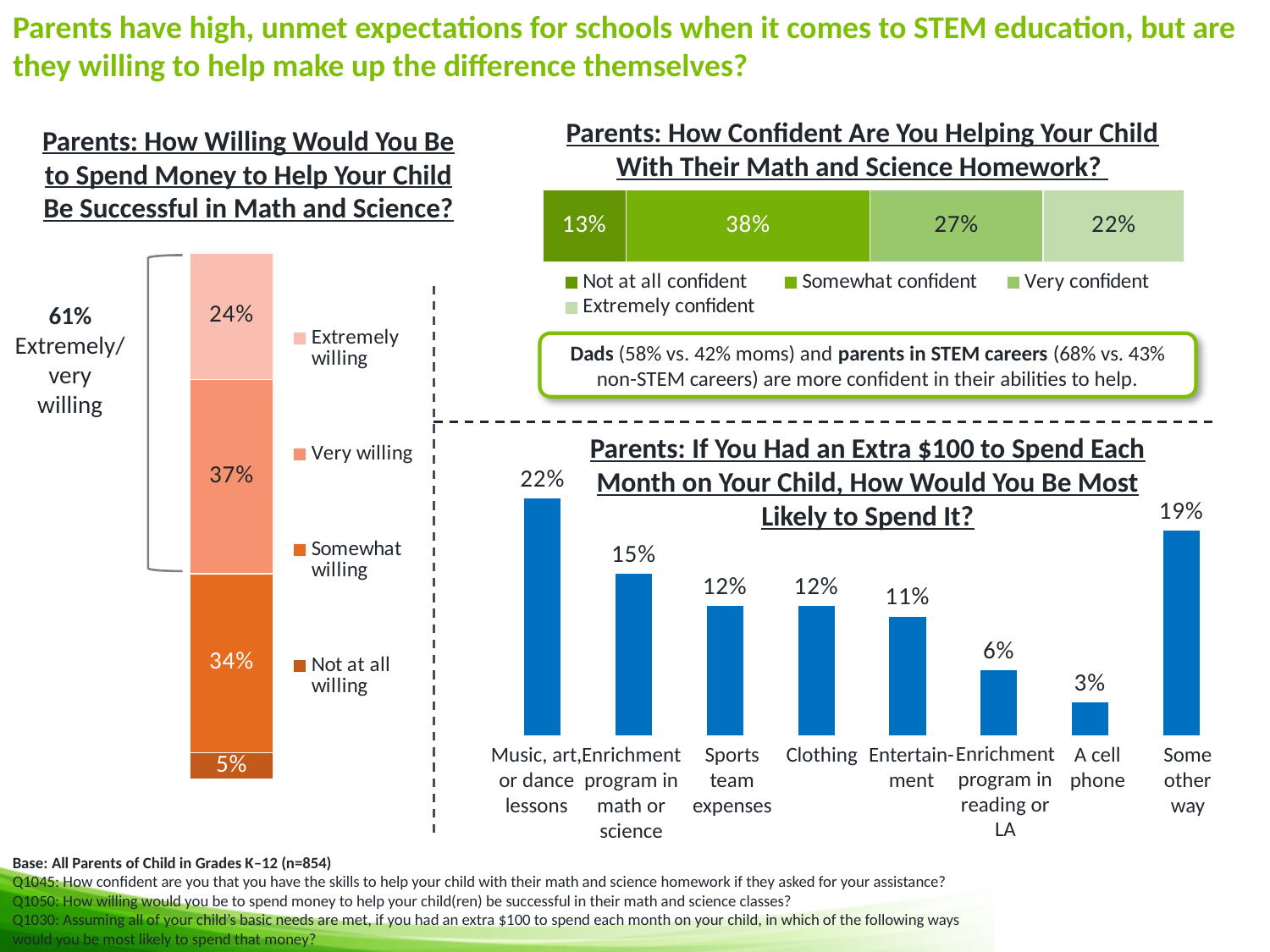
In the chart 'Parents: If You Had an Extra $100 to Spend Each Month on Your Child, How Would You Be Most Likely to Spend It?', which category has the lowest value? A cell phone In the chart 'Parents: How Confident Are You Helping Your Child With Their Math and Science Homework?', what is the value for 'Somewhat confident'? 38% In the chart 'Parents: If You Had an Extra $100 to Spend Each Month on Your Child, How Would You Be Most Likely to Spend It?', what is the difference between 'Music, art, or dance lessons' and 'Enrichment program in math or science'? 7% In the chart 'Parents: How Willing Would You Be to Spend Money to Help Your Child Be Successful in Math and Science?', what is the difference between 'Somewhat willing' and 'Not at all willing'? 29% What kind of chart is 'Parents: If You Had an Extra $100 to Spend Each Month on Your Child, How Would You Be Most Likely to Spend It?'? Bar chart How many categories are shown in the chart 'Parents: If You Had an Extra $100 to Spend Each Month on Your Child, How Would You Be Most Likely to Spend It?'? 8 In the chart 'Parents: How Willing Would You Be to Spend Money to Help Your Child Be Successful in Math and Science?', what is the value for 'Very willing'? 37% How many series does the legend list in the chart 'Parents: How Confident Are You Helping Your Child With Their Math and Science Homework?'? 4 In the chart 'Parents: If You Had an Extra $100 to Spend Each Month on Your Child, How Would You Be Most Likely to Spend It?', what is the value for 'A cell phone'? 3% In the chart 'Parents: If You Had an Extra $100 to Spend Each Month on Your Child, How Would You Be Most Likely to Spend It?', which is larger: 'Some other way' or 'Entertainment'? Some other way In the chart 'Parents: If You Had an Extra $100 to Spend Each Month on Your Child, How Would You Be Most Likely to Spend It?', which category has the highest value? Music, art, or dance lessons In the chart 'Parents: How Confident Are You Helping Your Child With Their Math and Science Homework?', which segment is the smallest? Not at all confident